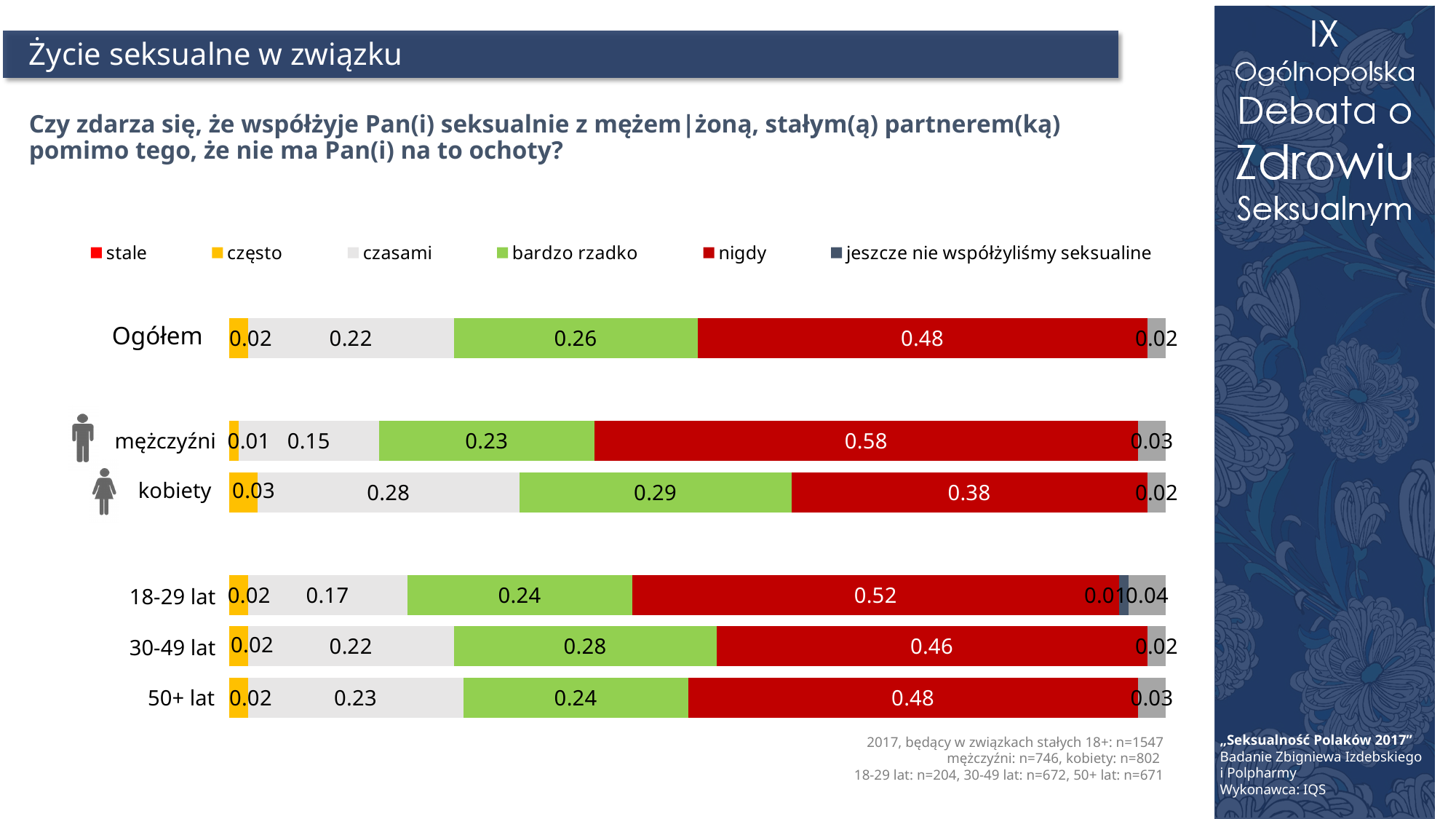
Which category has the highest value for "nigdy"? mężczyźni What is the value of "jeszcze nie współżyliśmy seksualine" for 18-29 lat? 0.01 What is the value of "nigdy" for mężczyźni? 0.58 How many series does the legend list? 6 What is the value of "czasami" for kobiety? 0.28 How many categories (bars) are shown in the chart? 6 Which category has the lowest value for "nigdy"? kobiety What kind of chart is shown on the slide? stacked bar chart What is the difference between the "nigdy" values for mężczyźni and kobiety? 0.20 Which has the larger "bardzo rzadko" value, kobiety or mężczyźni? kobiety What is the value of "bardzo rzadko" for 30-49 lat? 0.28 What is the value of "często" for kobiety? 0.03